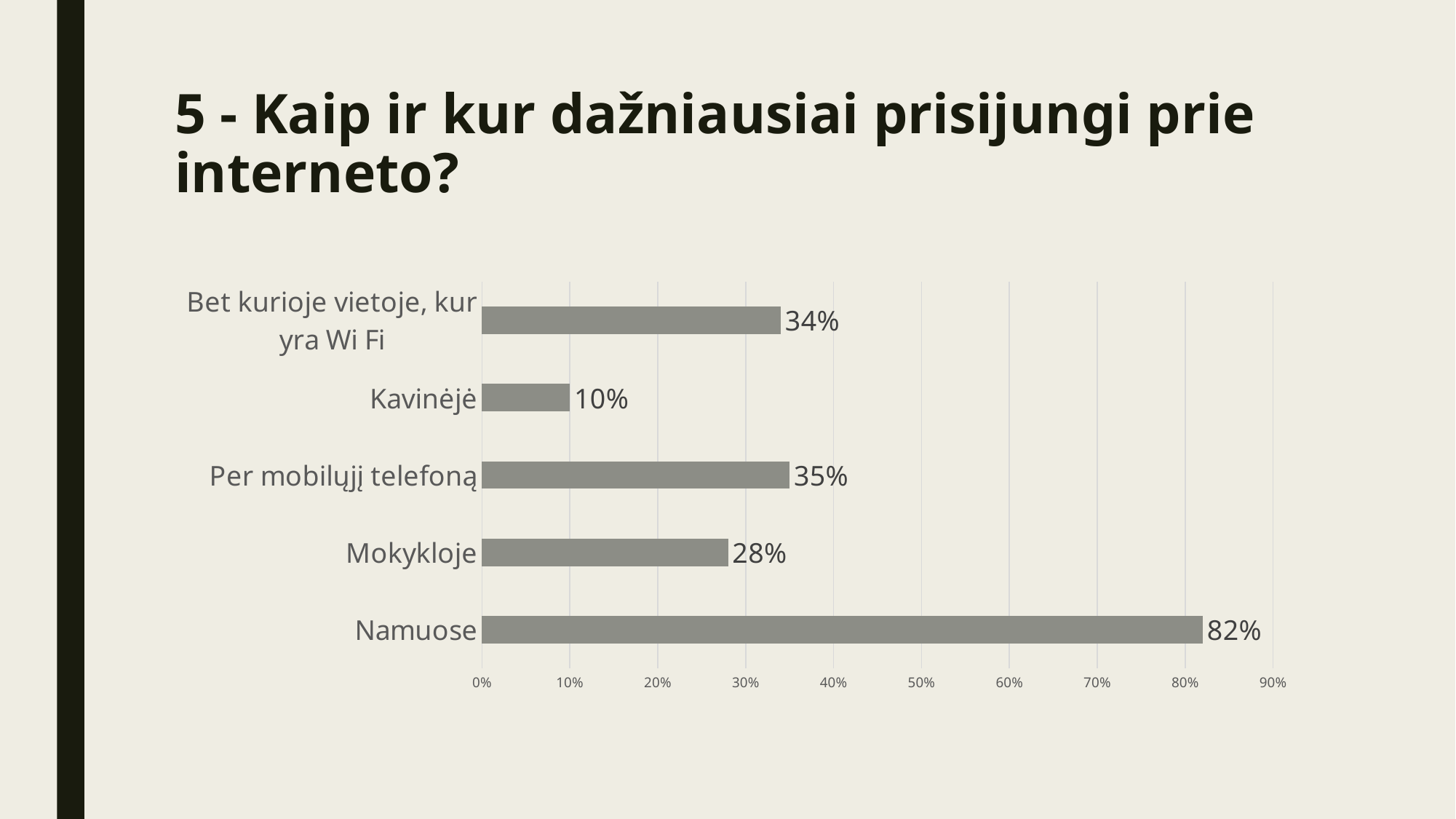
Is the value for Namuose greater or less than 80%? greater How many categories are shown in the chart? 5 What is the title of the slide? 5 - Kaip ir kur dažniausiai prisijungi prie interneto? What is the value for Kavinėjė? 10% What is the value for Namuose? 82% Which category has the highest value? Namuose What kind of chart is shown on the slide? bar chart What is the value for Per mobilųjį telefoną? 35% Which is larger, the value for Mokykloje or the value for Bet kurioje vietoje, kur yra Wi Fi? Bet kurioje vietoje, kur yra Wi Fi What is the value for Mokykloje? 28% Which category has the lowest value? Kavinėjė What is the difference between the values for Namuose and Mokykloje? 54%